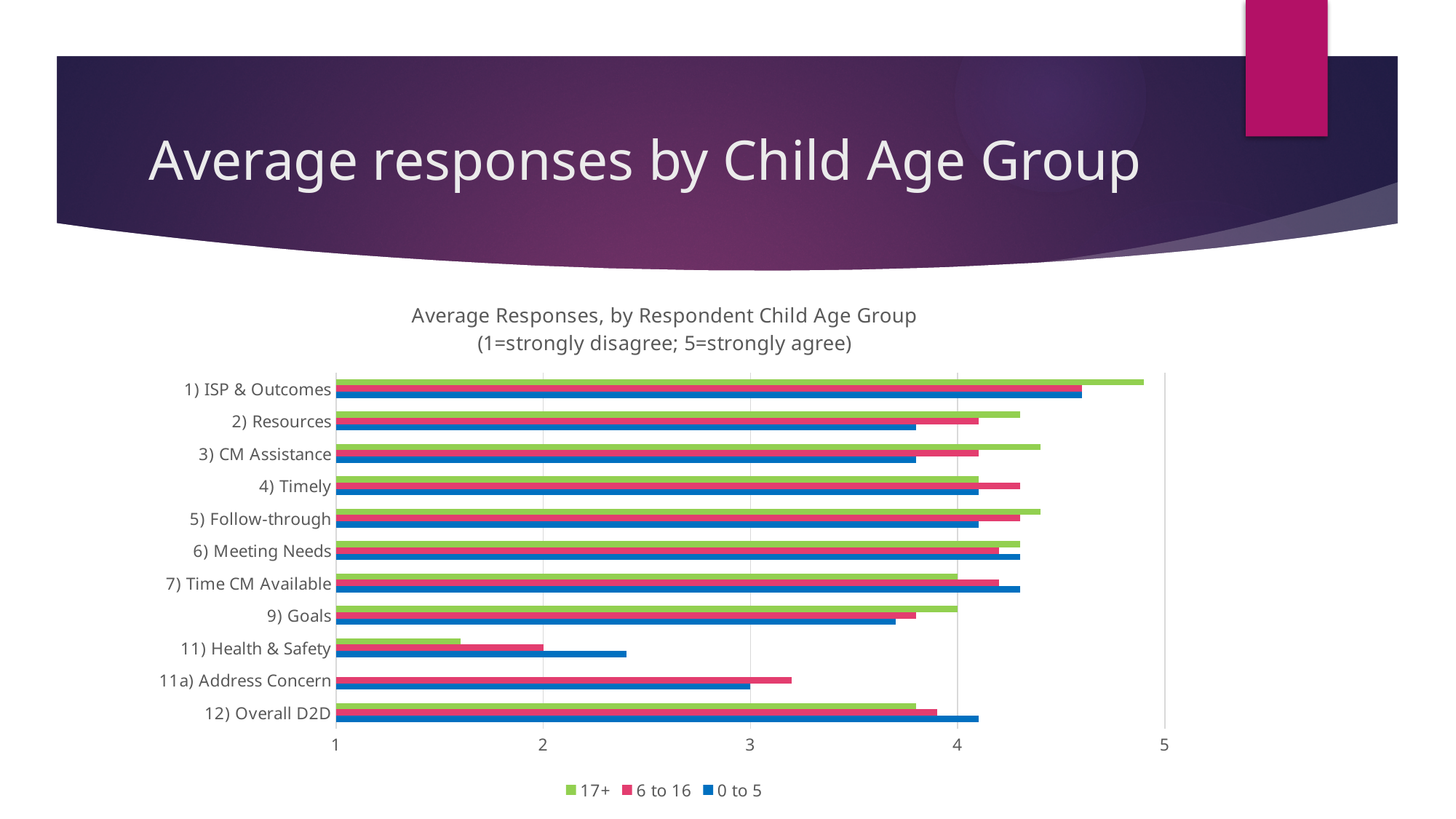
Is the value for 6 to 16 in 11a) Address Concern greater or less than 3? greater What kind of chart is shown on the slide? bar chart What is the title of the chart? Average Responses, by Respondent Child Age Group (1=strongly disagree; 5=strongly agree) Is the value for 0 to 5 in 2) Resources greater or less than 4? less Is the value for 17+ in 1) ISP & Outcomes greater or less than 4? greater How many series does the legend list? 3 Which category has the highest value for the 17+ series? 1) ISP & Outcomes In 11) Health & Safety, which is larger: the 0 to 5 value or the 17+ value? 0 to 5 How many categories are plotted on the vertical axis? 11 Which category has the lowest value for the 0 to 5 series? 11) Health & Safety